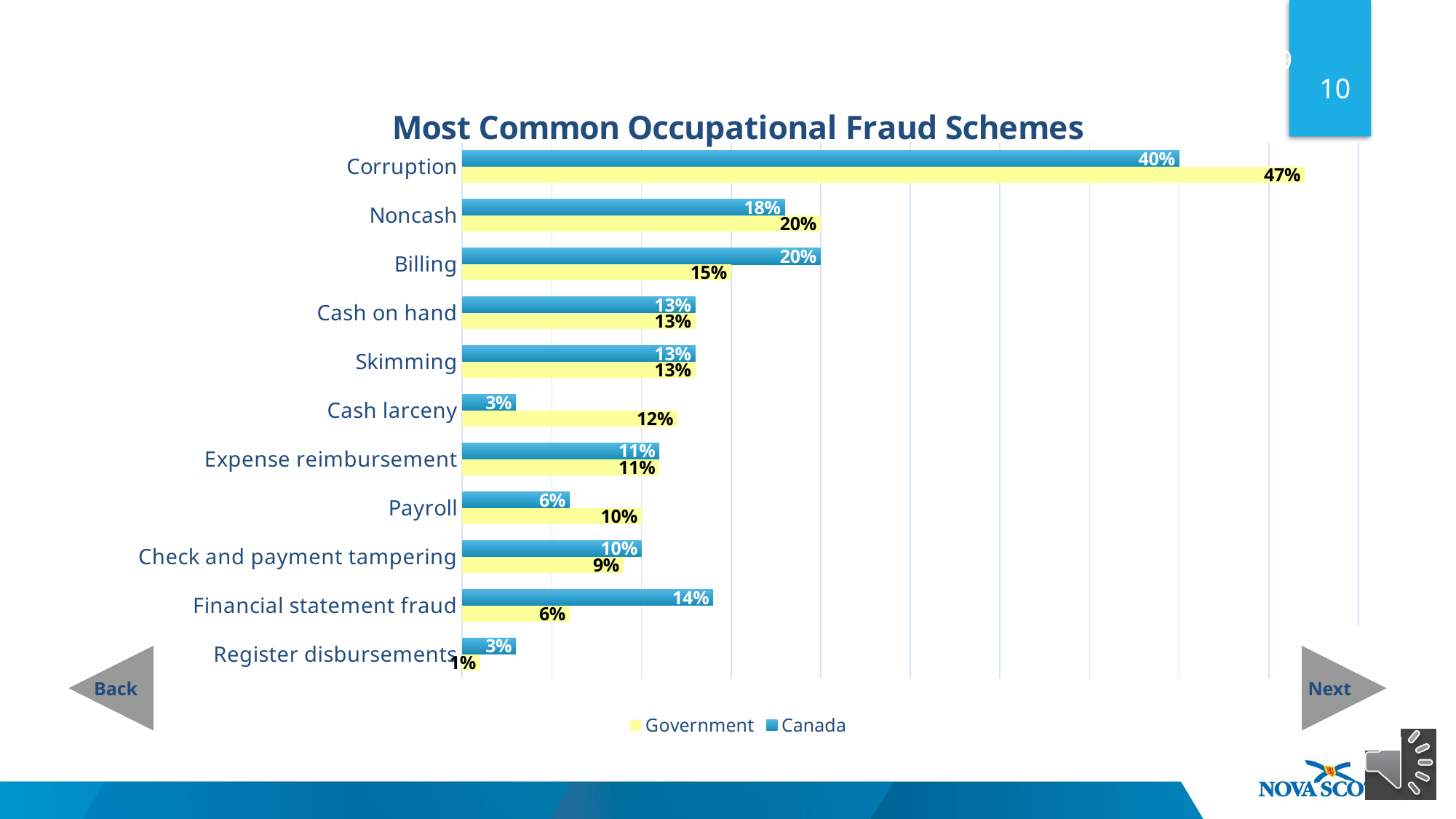
What kind of chart is shown on the slide? Bar chart Which category has the lowest Government value? Register disbursements Which category has the highest Canada value? Corruption What is the Canada value for Cash larceny? 3% How many categories are shown on the chart? 11 How many series does the legend list? 2 What is the Government value for Corruption? 47% What is the difference between the Government and Canada values for Corruption? 7% What is the Canada value for Billing? 20% What is the difference between the Government and Canada values for Cash larceny? 9% Which is larger for Payroll, the Government value or the Canada value? Government What is the Government value for Financial statement fraud? 6%